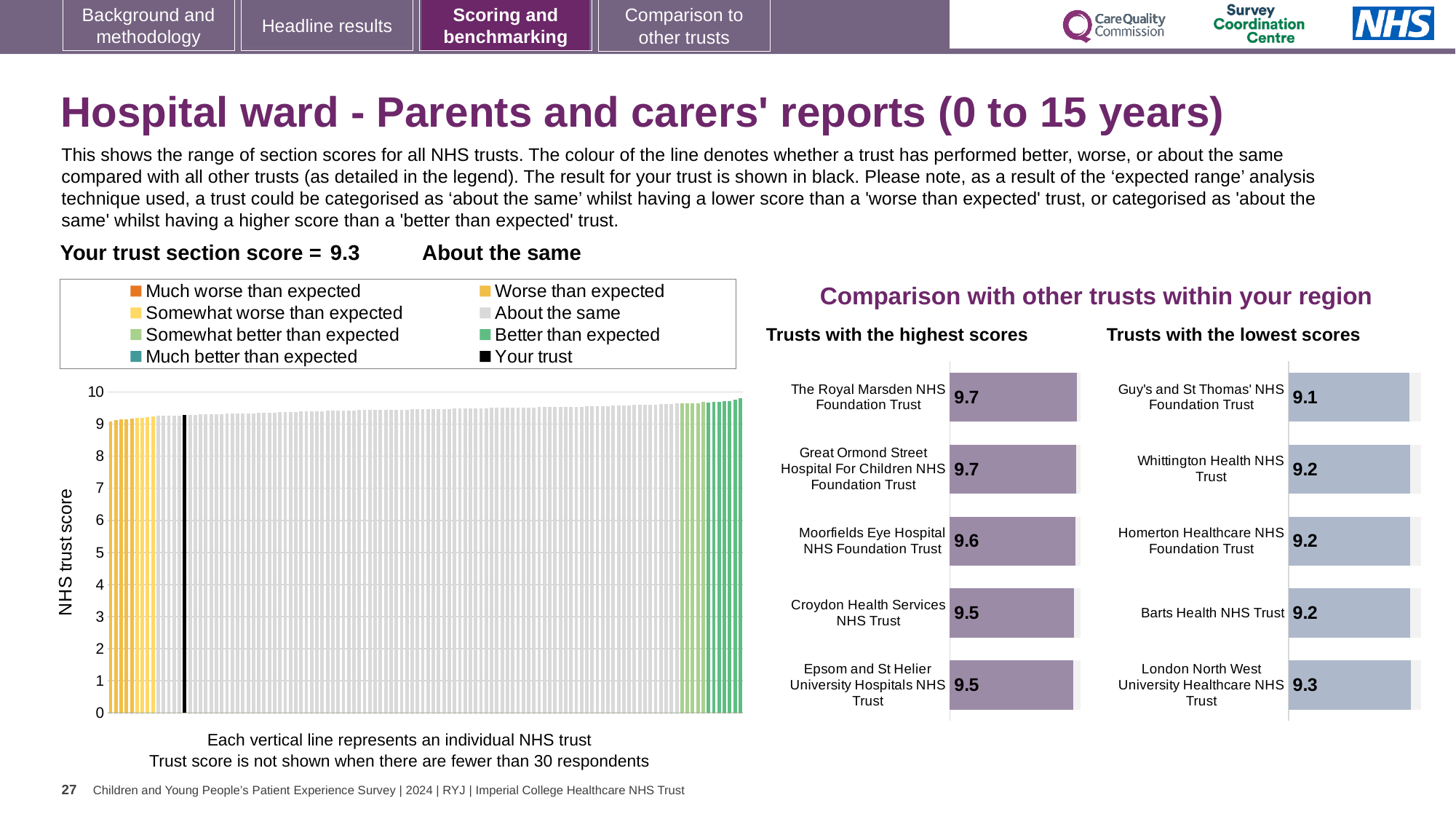
In the 'Trusts with the highest scores' chart, what is the difference between the scores of Moorfields Eye Hospital NHS Foundation Trust and Croydon Health Services NHS Trust? 0.1 In the 'Trusts with the highest scores' chart, what is the score for Croydon Health Services NHS Trust? 9.5 In the 'Trusts with the lowest scores' chart, which trust has the lowest score? Guy's and St Thomas' NHS Foundation Trust What kind of chart is the large chart on the left with the y axis labelled 'NHS trust score'? bar chart How many entries does the legend above the large chart on the left list? 8 In the large chart on the left, is the value for the black 'Your trust' bar greater or less than 5? greater How many trusts are shown in the 'Trusts with the lowest scores' chart? 5 In the 'Trusts with the highest scores' chart, what is the score for Moorfields Eye Hospital NHS Foundation Trust? 9.6 In the 'Trusts with the lowest scores' chart, what is the score for London North West University Healthcare NHS Trust? 9.3 In the 'Trusts with the highest scores' chart, which has the larger score: Moorfields Eye Hospital NHS Foundation Trust or Epsom and St Helier University Hospitals NHS Trust? Moorfields Eye Hospital NHS Foundation Trust In the large chart on the left, do the bar values rise or fall from left to right along the x axis? rise In the 'Trusts with the lowest scores' chart, what is the score for Guy's and St Thomas' NHS Foundation Trust? 9.1